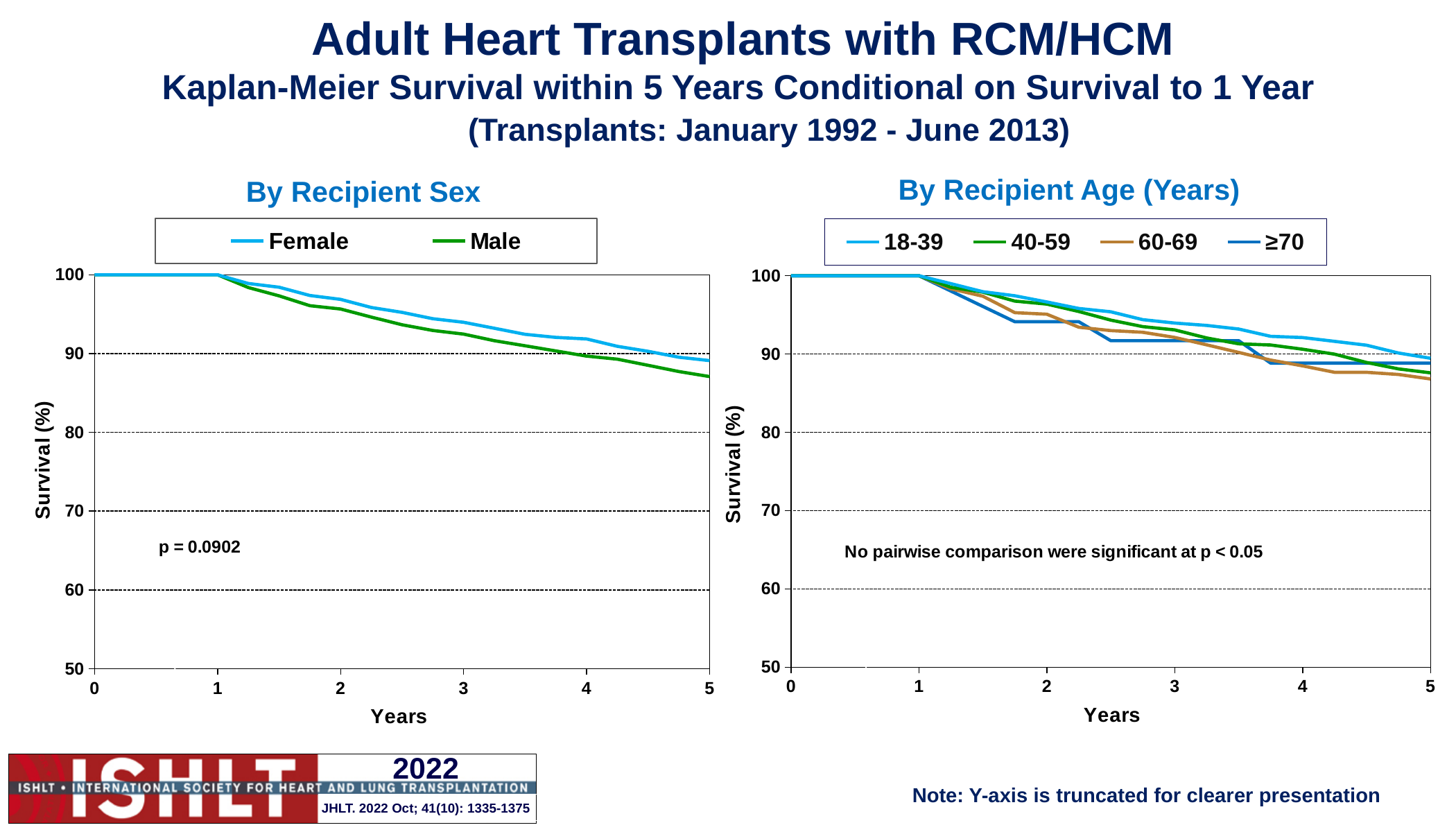
In the 'By Recipient Sex' chart, is the Female survival value at year 3 greater or less than 90? greater In the 'By Recipient Sex' chart, is the Male survival value at year 5 greater or less than 90? less What p-value is printed on the 'By Recipient Sex' chart? p = 0.0902 In the 'By Recipient Age (Years)' chart, is the survival value for 18-39 at year 3 greater or less than 90? greater How many series does the legend of the 'By Recipient Sex' chart list? 2 In the 'By Recipient Sex' chart, do the survival values rise or fall as years increase after year 1? fall In the 'By Recipient Age (Years)' chart, which series has the higher survival at year 2, 18-39 or ≥70? 18-39 In the 'By Recipient Sex' chart, which series has the higher survival at year 4, Female or Male? Female How many series does the legend of the 'By Recipient Age (Years)' chart list? 4 What is the y-axis label of the 'By Recipient Age (Years)' chart? Survival (%) What kind of chart is the 'By Recipient Sex' chart? line chart